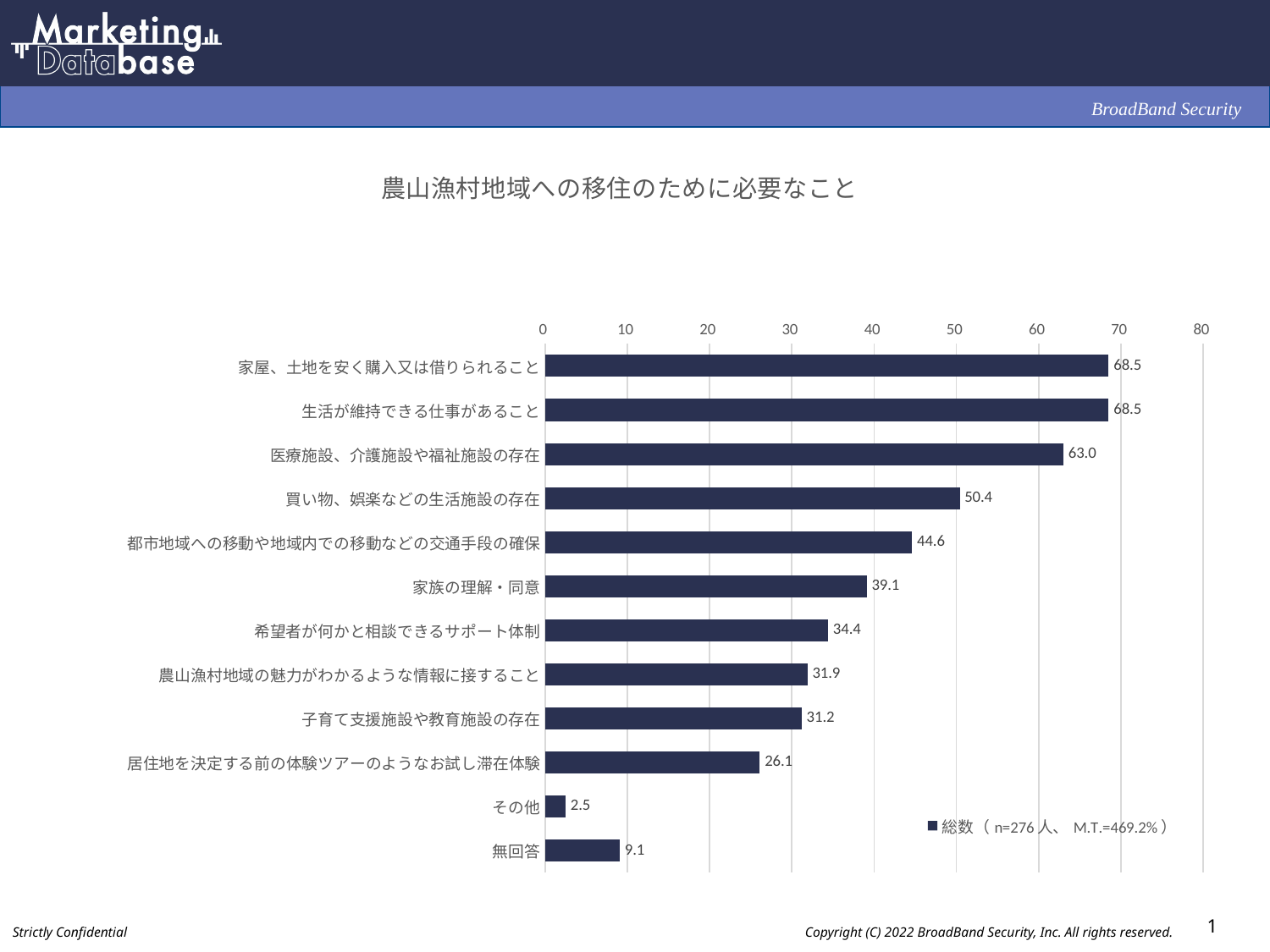
What is the value for 医療施設、介護施設や福祉施設の存在? 63.0 What is the difference between the values for 家屋、土地を安く購入又は借りられること and 医療施設、介護施設や福祉施設の存在? 5.5 How many categories are shown in the chart? 12 What is the difference between the values for 買い物、娯楽などの生活施設の存在 and 都市地域への移動や地域内での移動などの交通手段の確保? 5.8 What is the value for 無回答? 9.1 How many series does the legend list? 1 Which category has the lowest value? その他 What is the value for 家族の理解・同意? 39.1 What type of chart is shown on the slide? bar chart What is the value for 買い物、娯楽などの生活施設の存在? 50.4 What is the title of the chart? 農山漁村地域への移住のために必要なこと Which is larger, the value for 希望者が何かと相談できるサポート体制 or the value for 居住地を決定する前の体験ツアーのようなお試し滞在体験? 希望者が何かと相談できるサポート体制